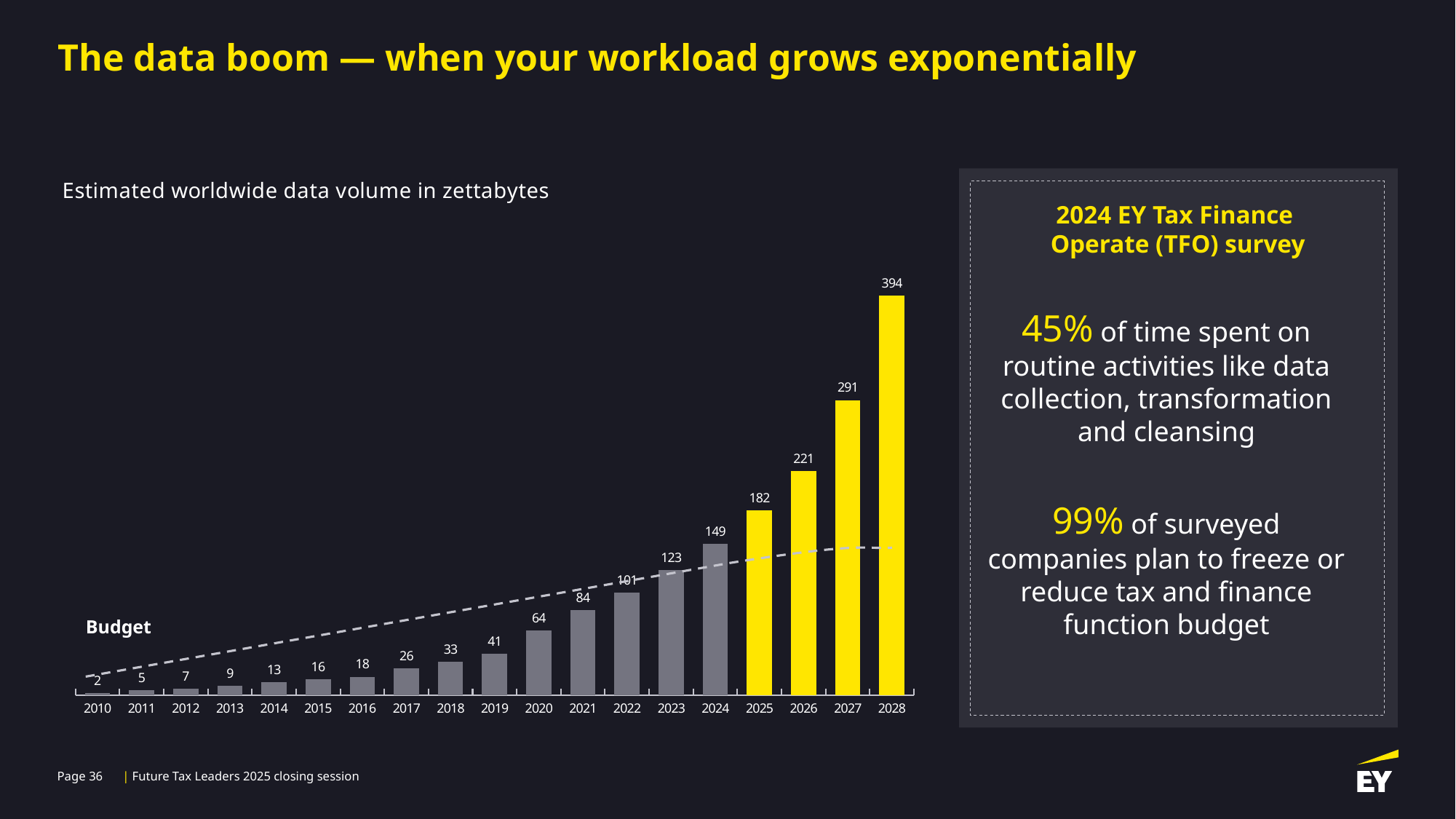
What is the estimated worldwide data volume in zettabytes for 2024? 149 What is the estimated worldwide data volume in zettabytes for 2028? 394 What is the estimated worldwide data volume in zettabytes for 2017? 26 Do the estimated data volume values rise or fall from 2010 to 2028? Rise What is the difference in zettabytes between the 2028 and 2027 values? 103 How many years are shown on the x axis of the chart? 19 Which is larger, the value for 2021 or the value for 2022? 2022 What is the difference in zettabytes between the 2025 and 2024 values? 33 What does the dashed line on the chart represent? Budget What kind of chart is used to show the estimated worldwide data volume? Bar chart Which year has the highest estimated worldwide data volume? 2028 Which year has the lowest estimated worldwide data volume? 2010